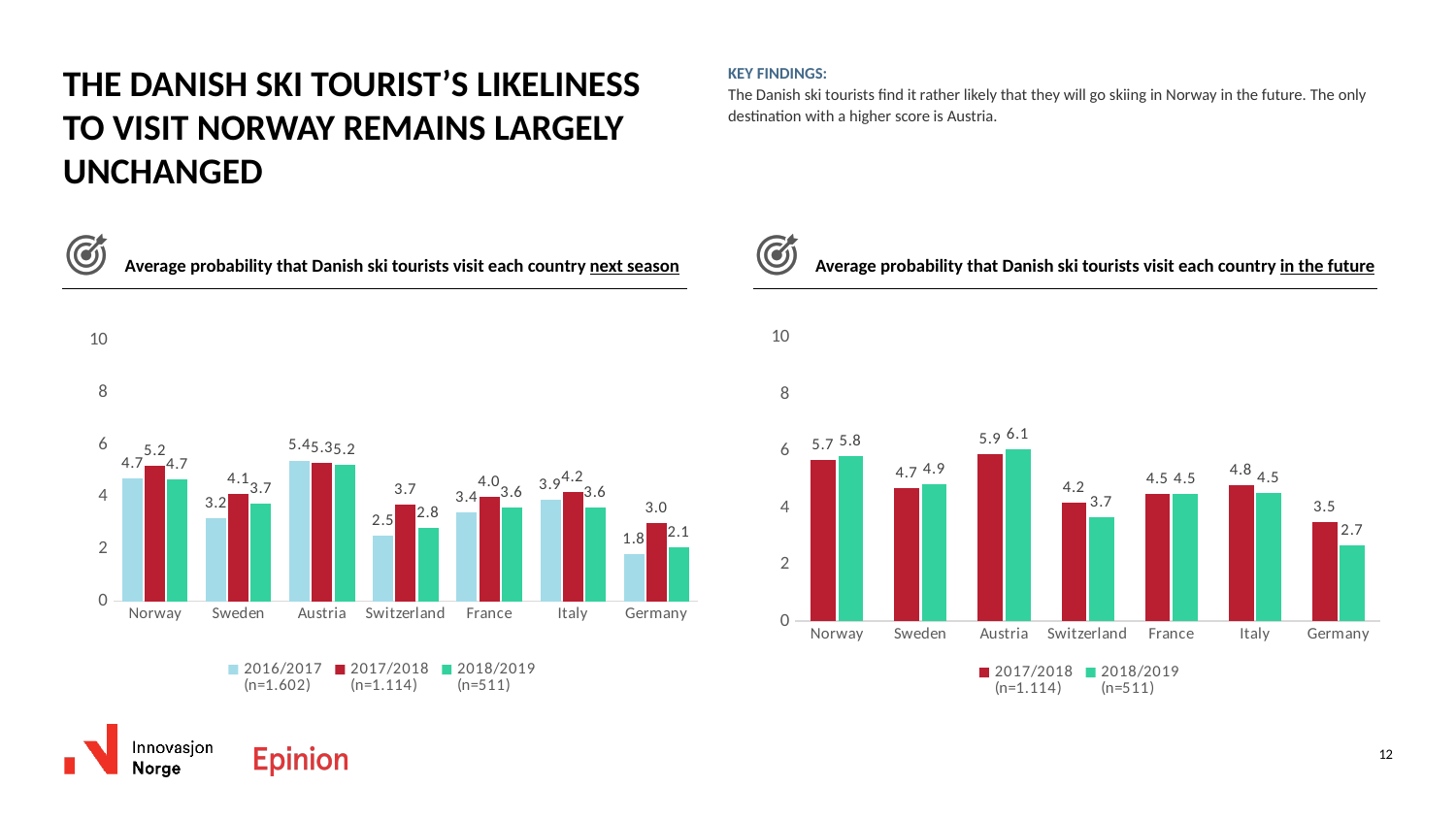
What type of chart is the 'in the future' chart? Bar chart In the 'in the future' chart, which country has the lowest value in the 2018/2019 series? Germany In the 'next season' chart, what is the value for Germany in the 2016/2017 series? 1.8 In the 'in the future' chart, which is larger for Italy: the 2017/2018 value or the 2018/2019 value? 2017/2018 In the 'next season' chart, what is the difference between the 2017/2018 and 2016/2017 values for Switzerland? 1.2 In the 'next season' chart, what is the value for Norway in the 2017/2018 series? 5.2 How many series does the legend of the 'next season' chart list? 3 In the 'in the future' chart, what is the difference between the 2017/2018 and 2018/2019 values for Germany? 0.8 In the 'next season' chart, which country has the lowest value in the 2017/2018 series? Germany In the 'next season' chart, which country has the highest value in the 2018/2019 series? Austria In the 'in the future' chart, what is the value for Austria in the 2018/2019 series? 6.1 How many countries are shown on the x axis of the 'in the future' chart? 7